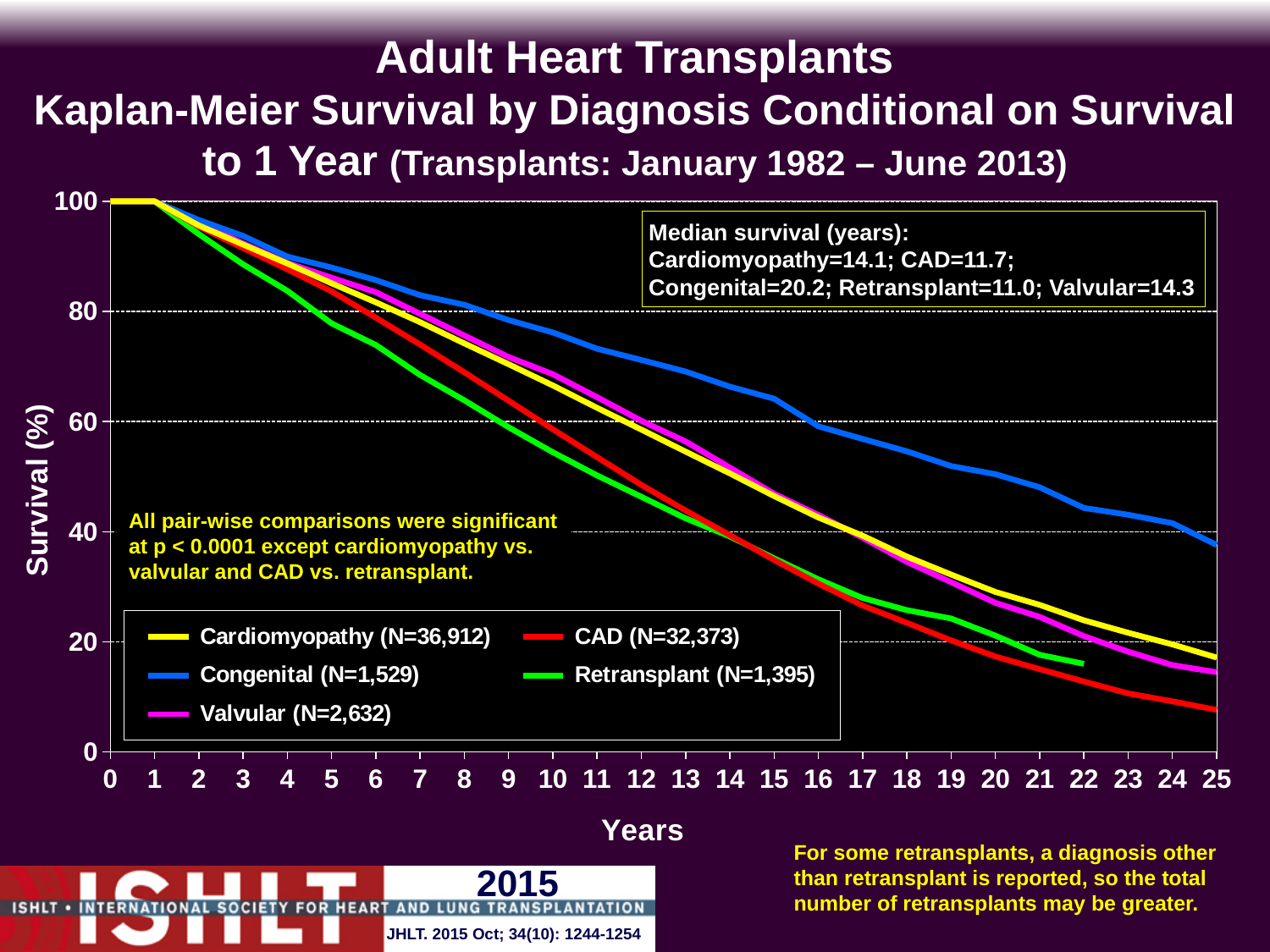
Which diagnosis group has the highest survival at 15 years? Congenital What is the difference in median survival (years) between Congenital and CAD? 8.5 Is the survival value for Congenital at 20 years greater or less than 40? greater What is the N for Cardiomyopathy shown in the legend? 36,912 Which diagnosis group has the lowest survival at 25 years? CAD What kind of chart is shown on the slide? line chart What is the median survival in years for Congenital according to the text box? 20.2 At 20 years, is survival higher for Congenital or for CAD? Congenital Is the survival value for CAD at 25 years greater or less than 20? less How many diagnosis groups (series) does the legend list? 5 Is the survival value for Cardiomyopathy at 10 years greater or less than 60? greater Do the survival curves rise or fall as years since transplant increase? fall